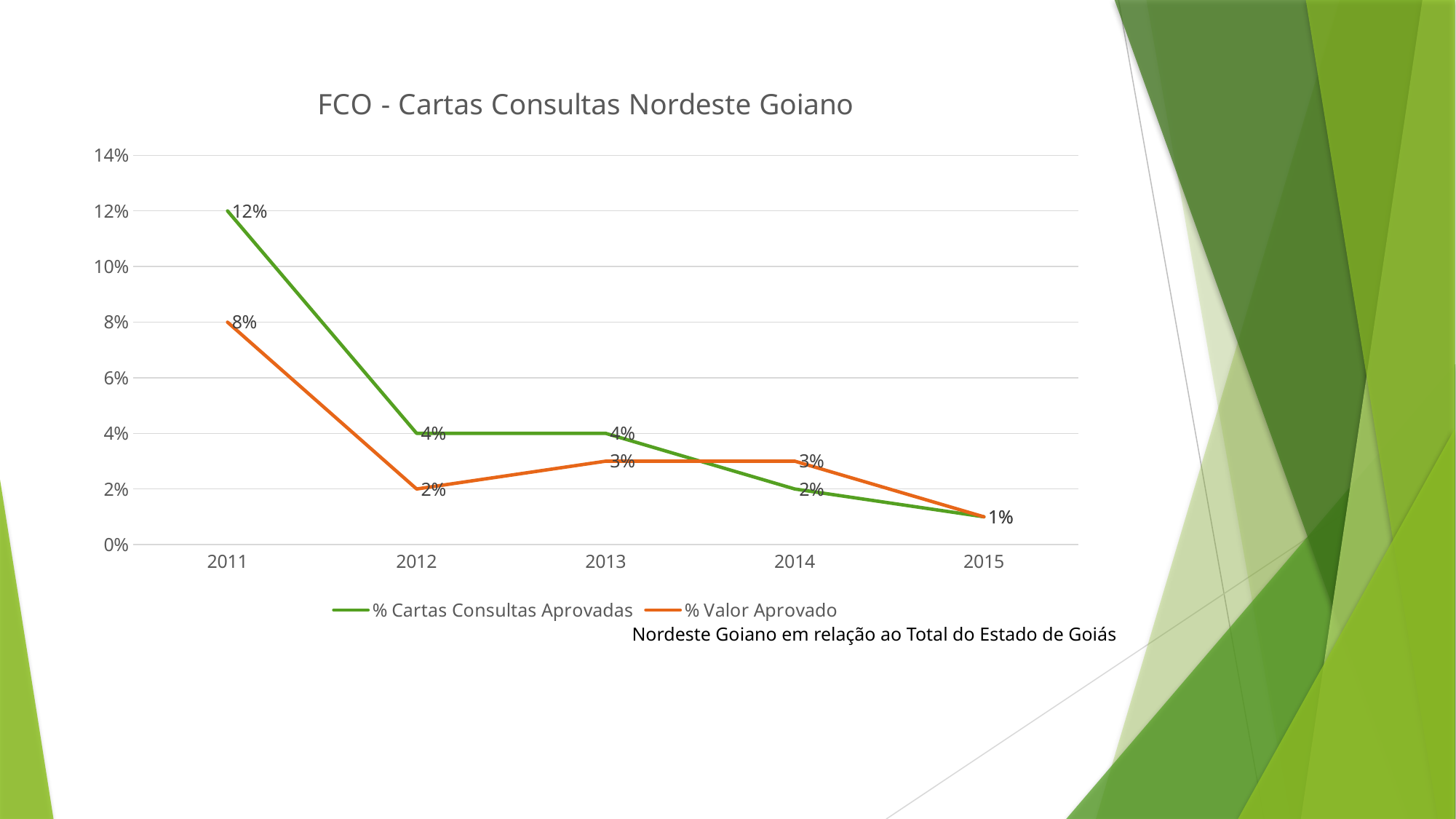
What kind of chart is shown on the slide? Line chart In 2014, which series has the larger value, % Cartas Consultas Aprovadas or % Valor Aprovado? % Valor Aprovado What is the title of the chart? FCO - Cartas Consultas Nordeste Goiano How many years are plotted along the x axis? 5 In which year is % Cartas Consultas Aprovadas highest? 2011 What is the value of % Valor Aprovado in 2011? 8% What is the value of % Cartas Consultas Aprovadas in 2011? 12% What is the difference between % Cartas Consultas Aprovadas and % Valor Aprovado in 2011? 4 percentage points What is the value of % Valor Aprovado in 2013? 3% Does % Cartas Consultas Aprovadas generally rise or fall from 2011 to 2015? Fall How many series does the legend list? 2 What is the value of % Cartas Consultas Aprovadas in 2014? 2%